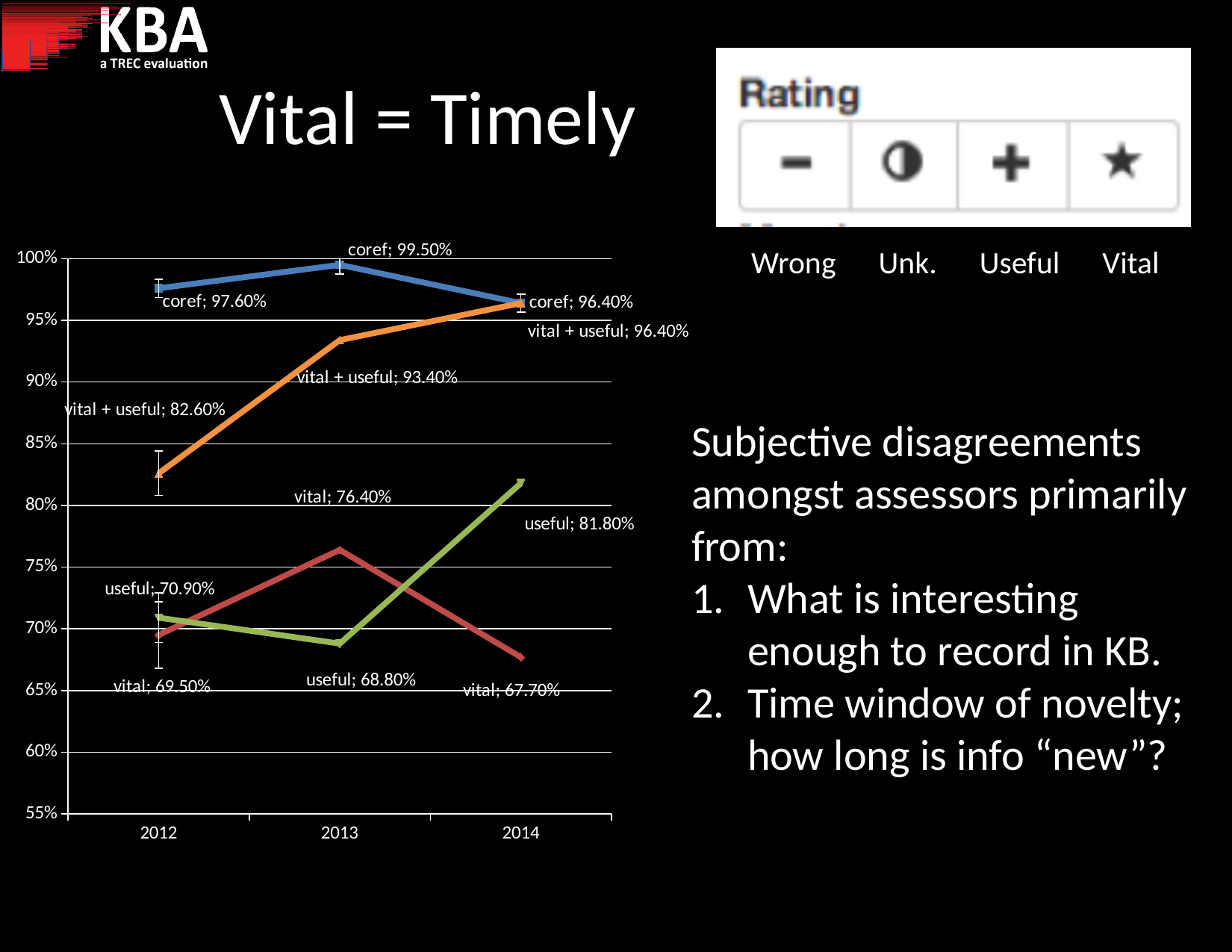
Which is larger in 2013, the useful value or the vital value? vital What is the vital + useful value for 2012? 82.60% Does the vital + useful series rise or fall from 2012 to 2014? rise What is the vital value for 2013? 76.40% How many years are shown on the x axis? 3 In which year is the coref value highest? 2013 How many data series are plotted in the chart? 4 What type of chart is shown on the slide? line chart What is the useful value for 2014? 81.80% What is the coref value for 2013? 99.50% In which year is the vital value lowest? 2014 What is the difference between the vital + useful values for 2014 and 2012? 13.80%